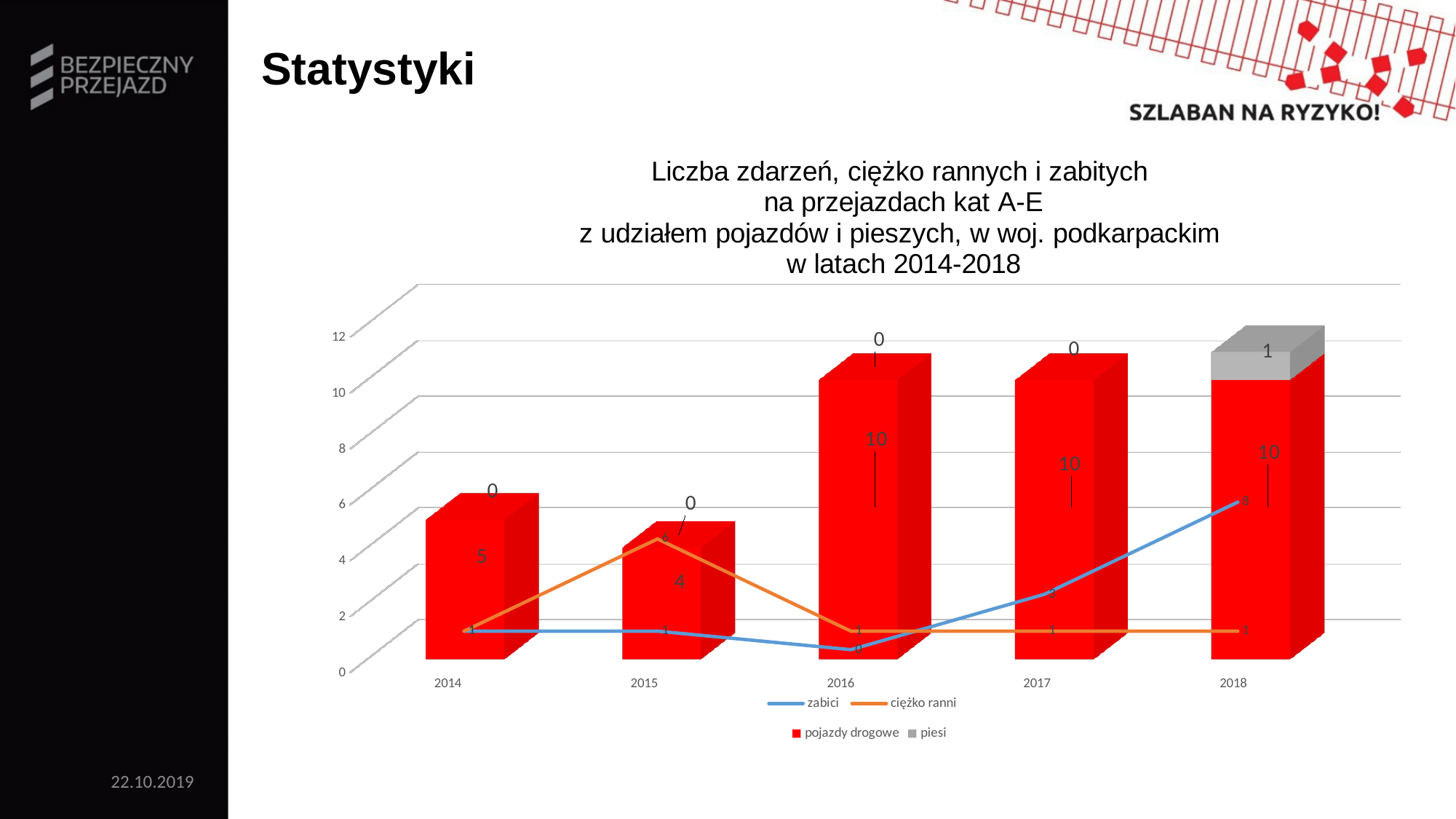
In which year is the pojazdy drogowe value lowest? 2015 What is the total of the stacked bar for 2018 (pojazdy drogowe plus piesi)? 11 What is the difference between the pojazdy drogowe values for 2016 and 2014? 5 What is the value for pojazdy drogowe in 2016? 10 What is the value of the zabici line in 2018? 8 What is the value for piesi in 2018? 1 Which is larger, the zabici value in 2017 or the ciężko ranni value in 2017? zabici What is the value of the ciężko ranni line in 2015? 6 In which year is the zabici value highest? 2018 How many series does the legend list? 4 How many years are shown on the x axis? 5 What is the value for pojazdy drogowe in 2015? 4